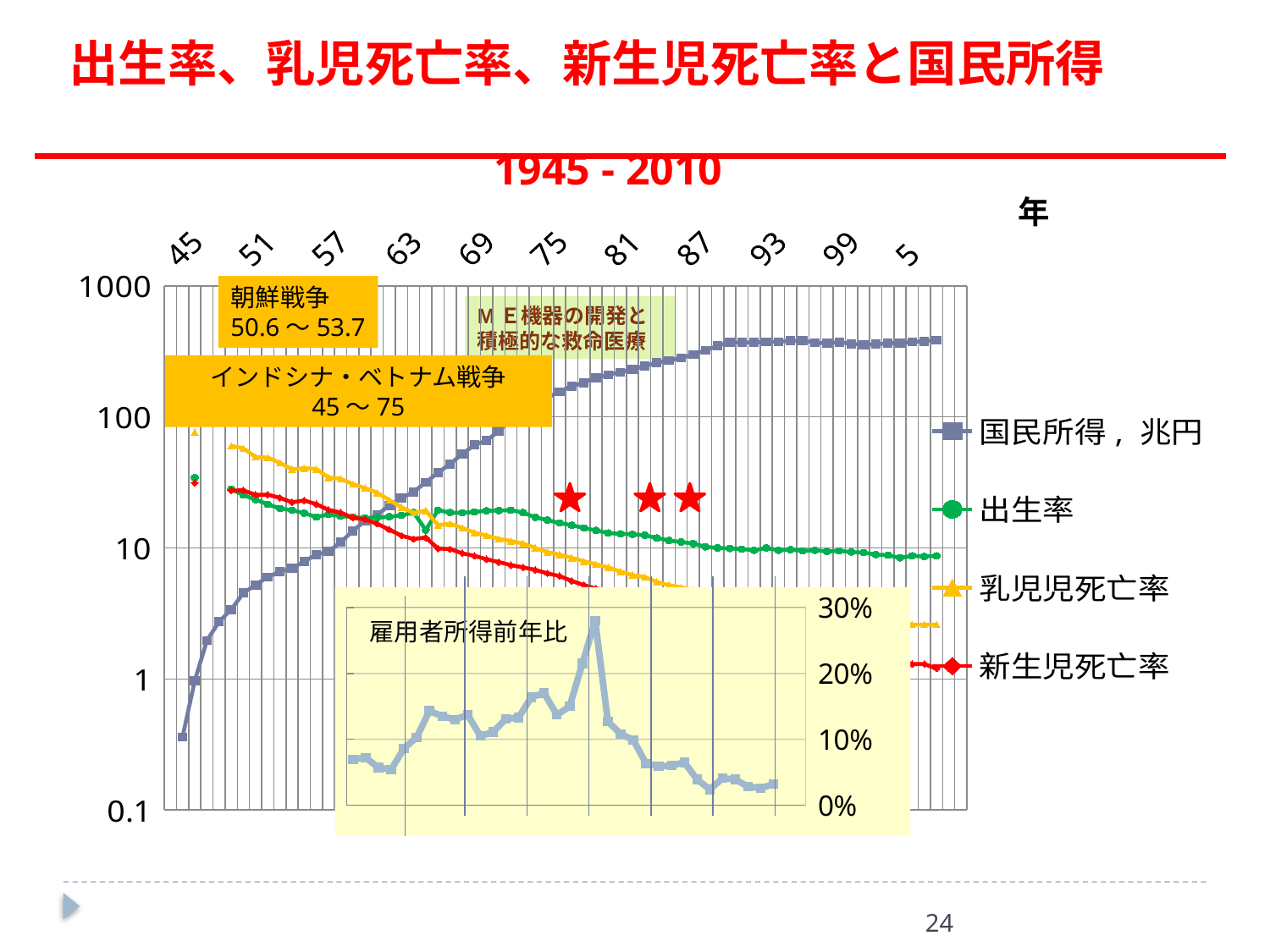
What kind of chart is the main chart on the slide? line chart In the main chart, does the 乳児児死亡率 series rise or fall along the x axis from 49 onward? fall In the main chart, is the value of 国民所得，兆円 at year 5 greater or less than 100? greater In the main chart, is the value of 国民所得，兆円 at year 45 greater or less than 1? less In the inset chart titled 雇用者所得前年比, is the peak value greater or less than 20%? greater How many series does the legend of the main chart list? 4 In the main chart, at year 5, which is larger: 国民所得，兆円 or 出生率? 国民所得，兆円 In the main chart, does the 国民所得，兆円 series rise or fall along the x axis from 45 onward? rise What is the title shown above the main chart? 1945 - 2010 In the main chart, which series is drawn with purple square markers? 国民所得，兆円